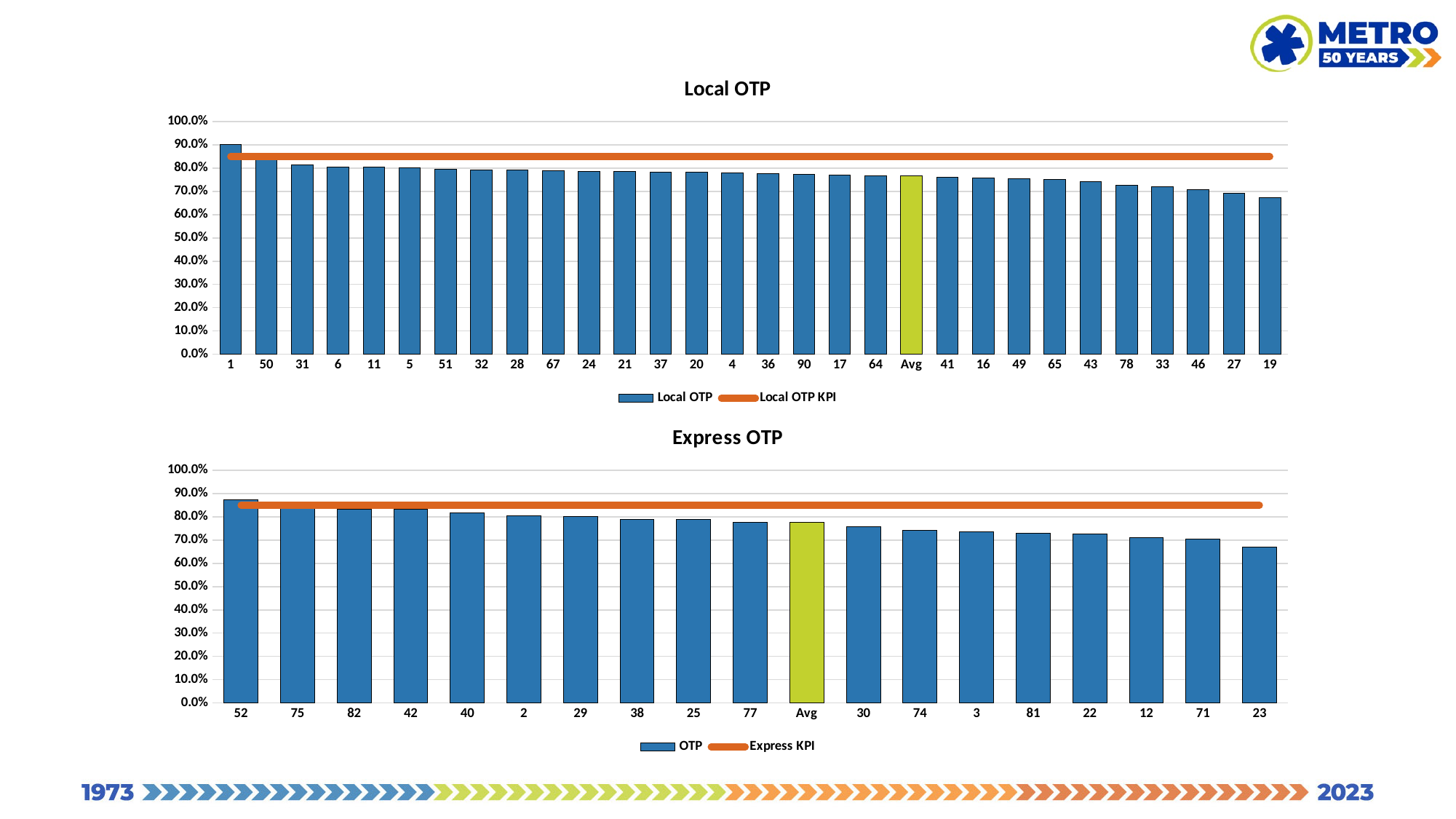
On the Local OTP chart, is the value for route 1 greater or less than 80.0%? greater On the Express OTP chart, is the value for route 23 greater or less than 70.0%? less On the Express OTP chart, how many bars are plotted along the x axis, including Avg? 19 On the Local OTP chart, is the value for route 19 greater or less than 70.0%? less On the Local OTP chart, which route has the highest OTP? 1 On the Local OTP chart, which route has the lowest OTP? 19 On the Local OTP chart, how many bars are plotted along the x axis, including Avg? 30 On the Local OTP chart, do the bar values rise or fall from left to right? fall What kind of chart is the Express OTP chart? combination bar and line chart On the Express OTP chart, which route has the highest OTP? 52 On the Express OTP chart, which route has the lowest OTP? 23 On the Local OTP chart, how many entries does the legend list? 2